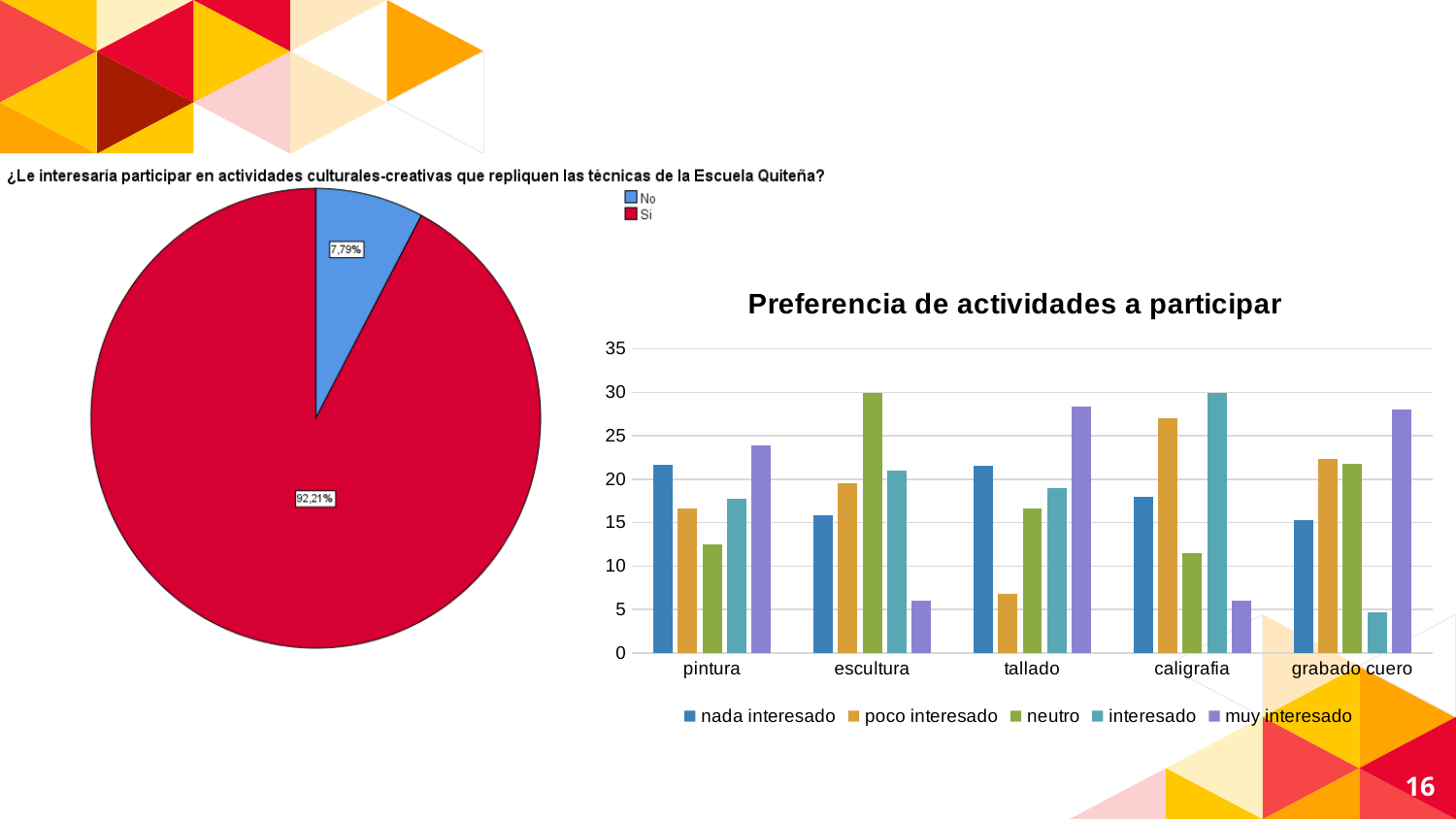
In "Preferencia de actividades a participar", which is larger for pintura: "nada interesado" or "neutro"? nada interesado On the pie chart on the left, what is the difference in percentage points between the "Si" and "No" slices? 84,42% On the pie chart on the left, what percentage of respondents answered "Si"? 92,21% How many activity categories are shown on the x axis of "Preferencia de actividades a participar"? 5 What kind of chart is "Preferencia de actividades a participar"? Bar chart In "Preferencia de actividades a participar", is the value for "neutro" in escultura greater or less than 25? greater In "Preferencia de actividades a participar", which series has the highest bar for tallado? muy interesado In "Preferencia de actividades a participar", is the value for "muy interesado" in escultura greater or less than 10? less What kind of chart is the chart on the left of the slide? Pie chart On the pie chart on the left, which answer has the larger share? Si On the pie chart on the left, what percentage of respondents answered "No"? 7,79% How many series does the legend of "Preferencia de actividades a participar" list? 5